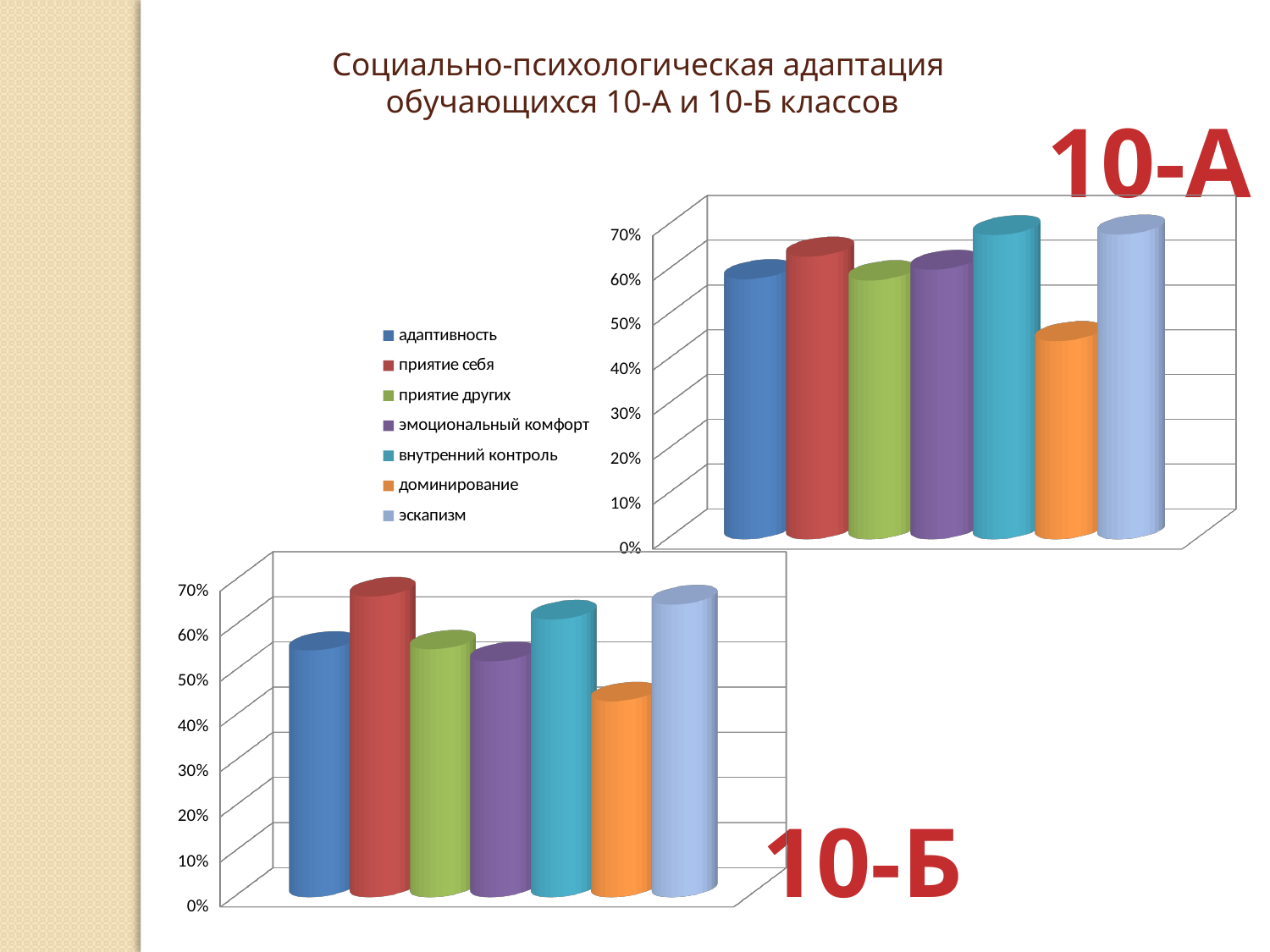
What kind of chart is the 10-А chart? bar chart In the 10-А chart, is the value for внутренний контроль greater or less than 60%? greater In the 10-А chart, which series has the lowest value? доминирование In the 10-Б chart, which series has the lowest value? доминирование How many series does the legend list? 7 In the 10-А chart, which is larger: эскапизм or доминирование? эскапизм In the 10-Б chart, is the value for приятие себя greater or less than 60%? greater In the 10-Б chart, is the value for доминирование greater or less than 50%? less In the 10-Б chart, which is larger: приятие себя or адаптивность? приятие себя How many bars are plotted in the 10-Б chart? 7 In the 10-Б chart, which series has the highest value? приятие себя